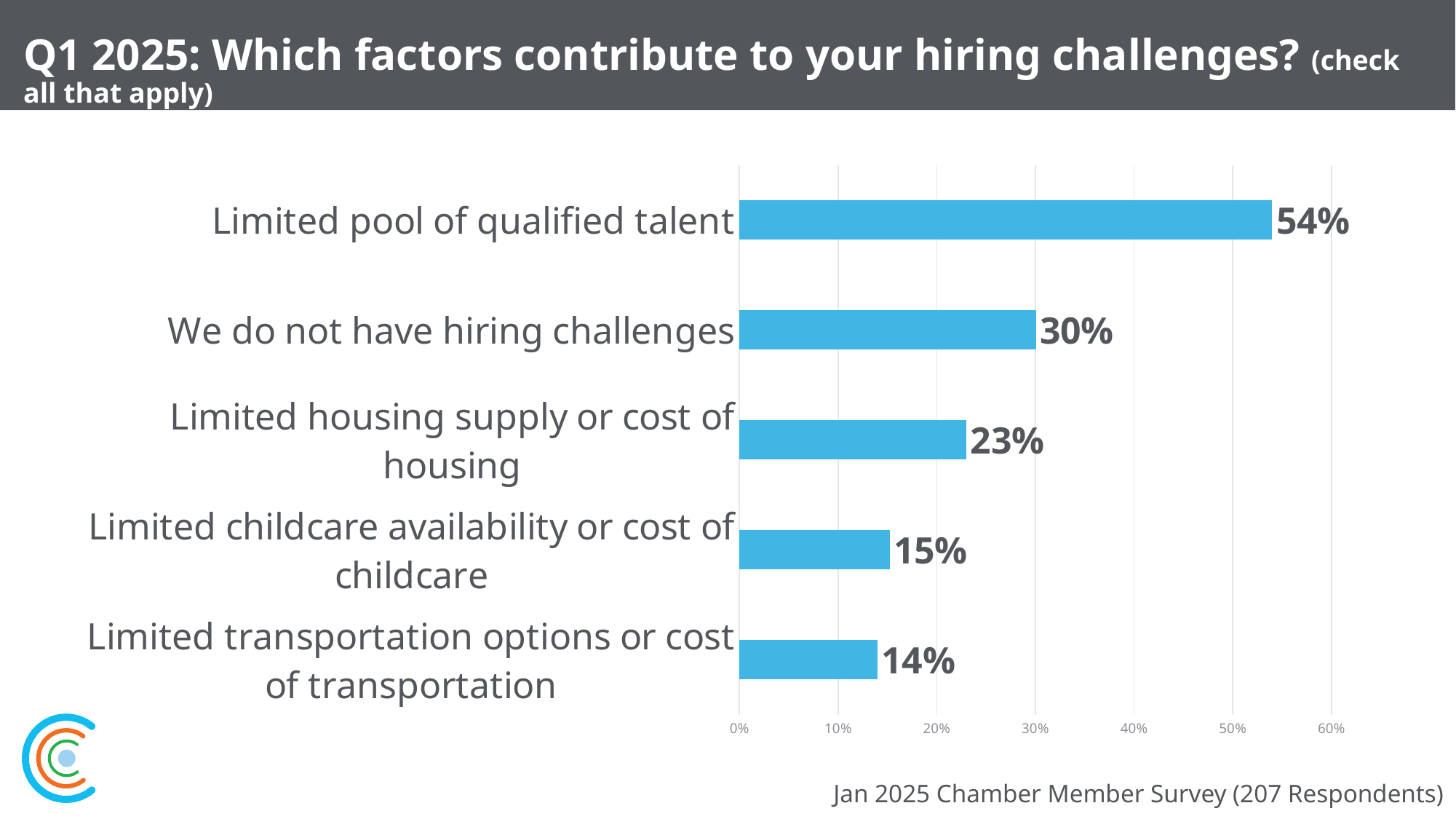
What type of chart is shown on the slide? Bar chart What percentage of respondents said "We do not have hiring challenges"? 30% What is the value for "Limited transportation options or cost of transportation"? 14% How many categories are shown in the chart? 5 What is the value for "Limited childcare availability or cost of childcare"? 15% Which category has the lowest percentage? Limited transportation options or cost of transportation What percentage of respondents selected "Limited pool of qualified talent"? 54% What is the value for "Limited housing supply or cost of housing"? 23% Which factor has the highest percentage? Limited pool of qualified talent Which is larger: the value for "Limited housing supply or cost of housing" or the value for "Limited childcare availability or cost of childcare"? Limited housing supply or cost of housing What is the difference in percentage points between "Limited pool of qualified talent" and "We do not have hiring challenges"? 24 percentage points According to the footnote, how many respondents took part in the survey? 207